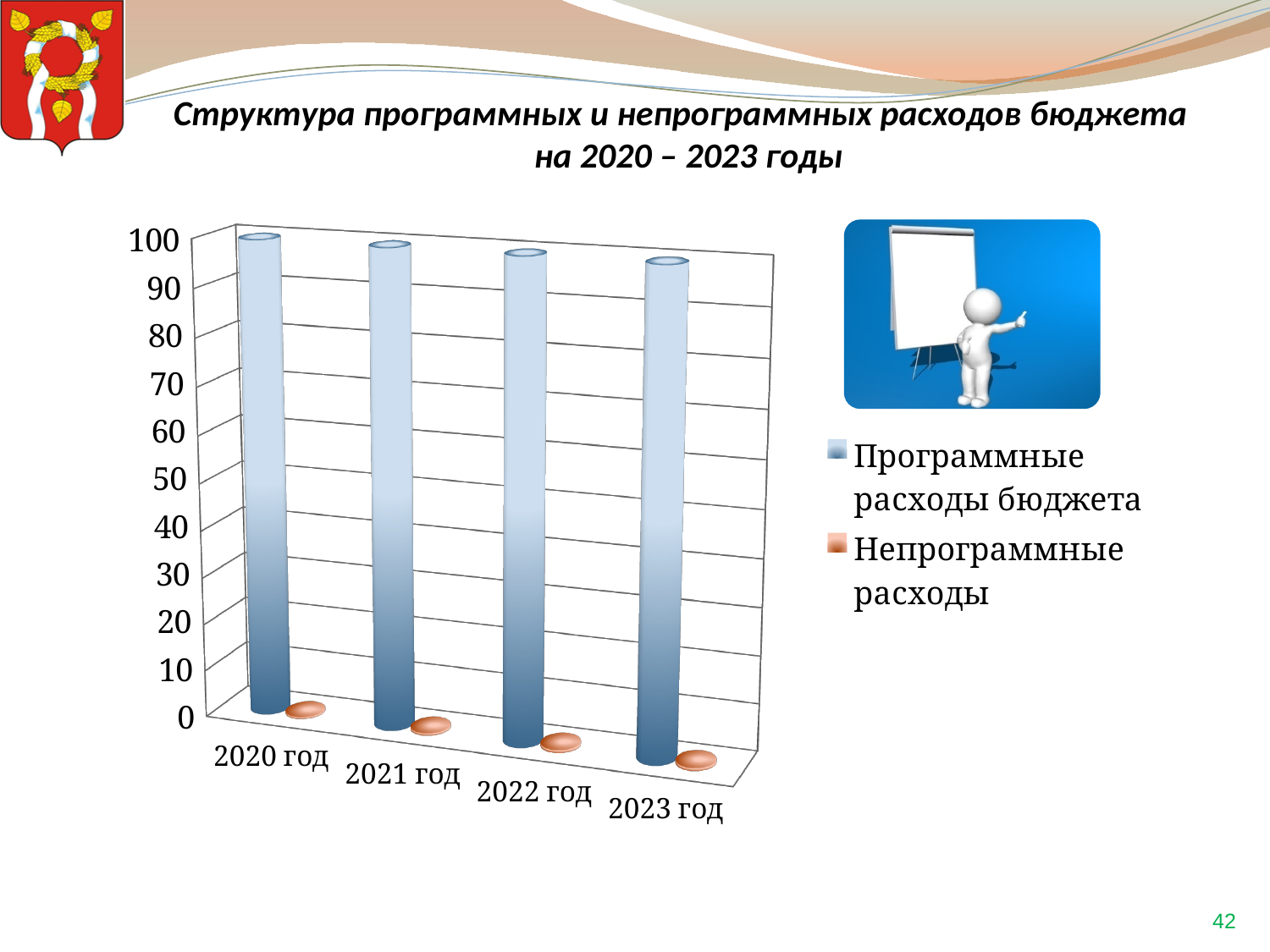
Is the value for Программные расходы бюджета in 2023 год greater or less than 80? greater In 2022 год, which series has the larger value: Программные расходы бюджета or Непрограммные расходы? Программные расходы бюджета In 2020 год, which series has the smaller value: Программные расходы бюджета or Непрограммные расходы? Непрограммные расходы What is the title of the chart on the slide? Структура программных и непрограммных расходов бюджета на 2020 – 2023 годы Is the value for Программные расходы бюджета in 2020 год greater or less than 90? greater What is the highest value shown on the vertical axis of the chart? 100 Which series is shown in orange in the chart legend? Непрограммные расходы How many years (categories) are shown on the x axis of the chart? 4 How many series does the chart legend list? 2 Is the value for Непрограммные расходы in 2023 год greater or less than 20? less What kind of chart is shown on the slide? bar chart